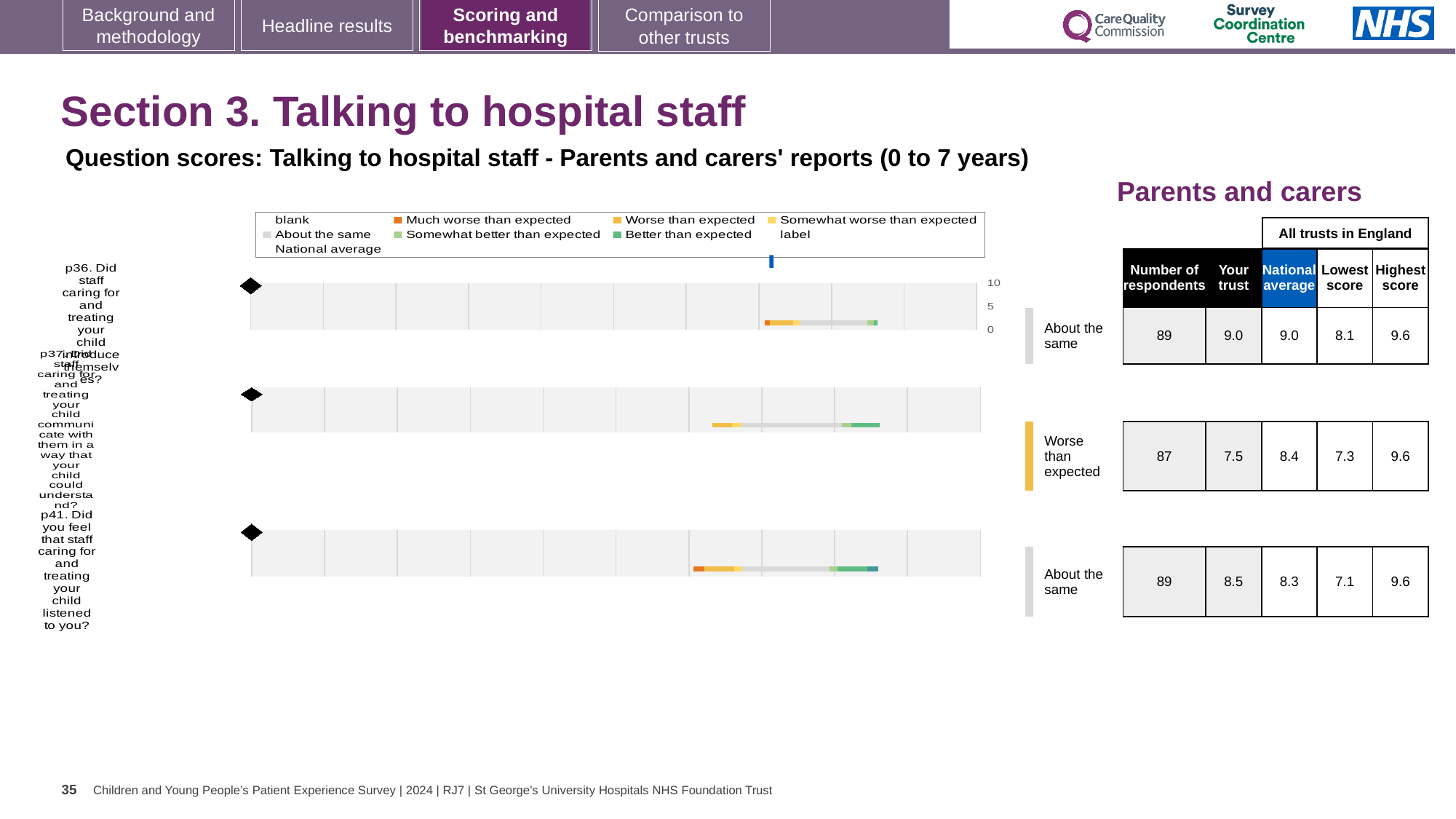
How many survey questions (p36, p37, p41) are plotted in the chart? 3 For p41, which is larger: the 'Your trust' score or the National average? Your trust What benchmark category is shown for p37? Worse than expected How many respondents answered p37? 87 What is the 'Your trust' score for p37 (Did staff communicate with them in a way your child could understand)? 7.5 What kind of chart is used to show the question scores for Talking to hospital staff? bar chart What is the 'Your trust' score for p36 (Did staff caring for and treating your child introduce themselves)? 9.0 Which question has the highest 'Your trust' score? p36 How many entries does the chart legend list? 9 Which question has the lowest 'Your trust' score? p37 What is the National average score for p41 (Did you feel that staff listened to you)? 8.3 For p37, how much lower is the 'Your trust' score than the National average? 0.9